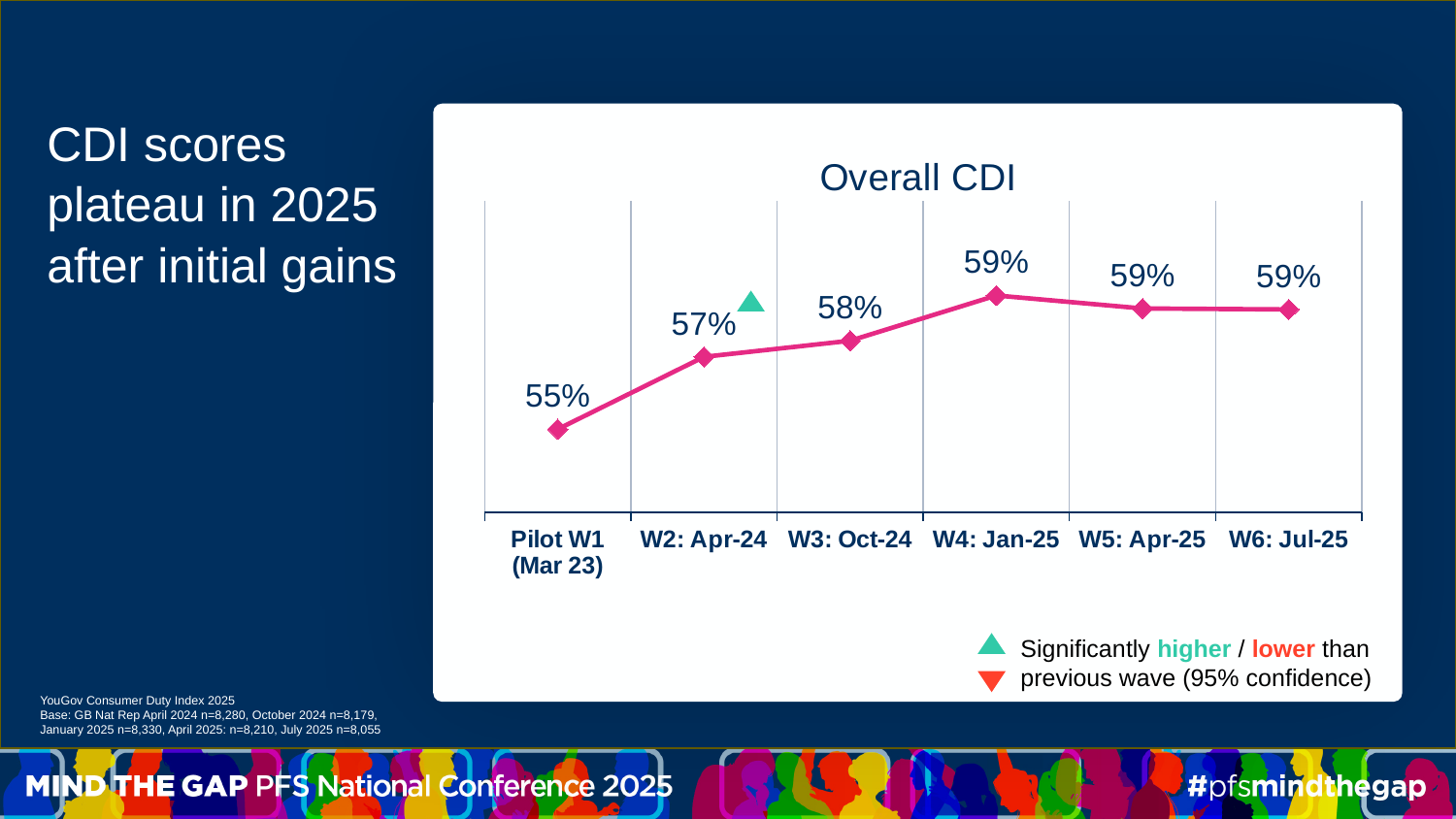
What kind of chart is used to show Overall CDI? Line chart Which wave is marked with a green triangle indicating a significantly higher score than the previous wave? W2: Apr-24 Do the Overall CDI values rise or fall from Pilot W1 (Mar 23) to W4: Jan-25? Rise What is the Overall CDI value for W3: Oct-24? 58% What is the Overall CDI value for W2: Apr-24? 57% What is the difference between the Overall CDI values for W4: Jan-25 and Pilot W1 (Mar 23)? 4% Which wave has the lowest Overall CDI value? Pilot W1 (Mar 23) What is the title of the chart? Overall CDI What is the Overall CDI value for W6: Jul-25? 59% What is the Overall CDI value for Pilot W1 (Mar 23)? 55% How many waves are plotted on the Overall CDI chart? 6 Which is larger, the Overall CDI value for W2: Apr-24 or for W3: Oct-24? W3: Oct-24